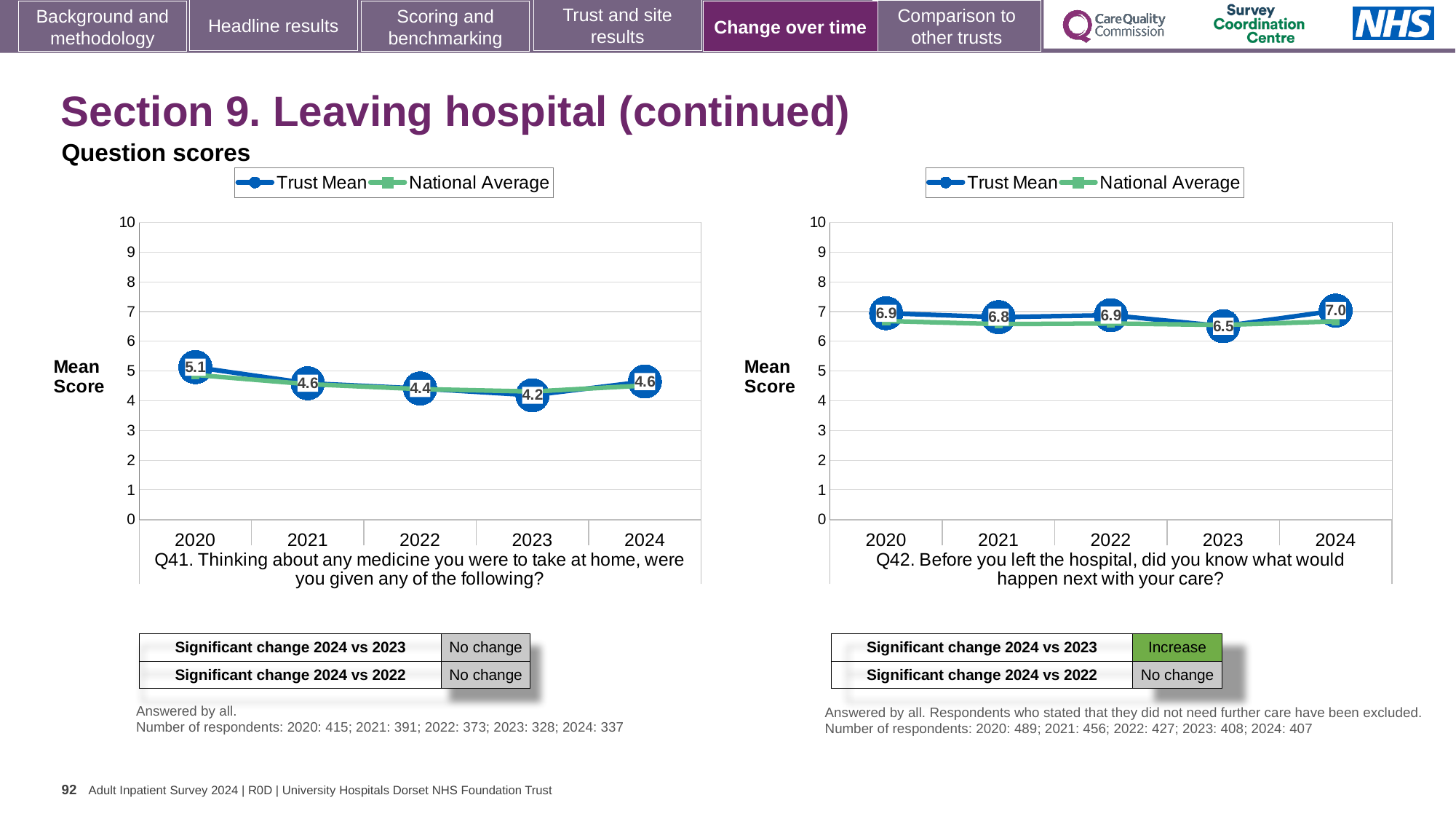
On the Q42 chart (right), what is the Trust Mean score for 2023? 6.5 On the Q42 chart (right), is the Trust Mean score for 2021 higher or lower than the score for 2023? higher On the Q42 chart (right), what is the difference between the Trust Mean scores for 2024 and 2023? 0.5 On the Q42 chart (right), what is the Trust Mean score for 2024? 7.0 How many years are plotted on the Q41 chart (left)? 5 How many series does the legend of the Q42 chart (right) list? 2 On the Q41 chart (left), what is the difference between the Trust Mean scores for 2020 and 2023? 0.9 On the Q42 chart (right), which year has the lowest Trust Mean score? 2023 On the Q41 chart (left), what is the Trust Mean score for 2023? 4.2 On the Q41 chart (left), which year has the highest Trust Mean score? 2020 On the Q41 chart (left), what is the Trust Mean score for 2020? 5.1 What type of chart is used for Q41 (left)? line chart